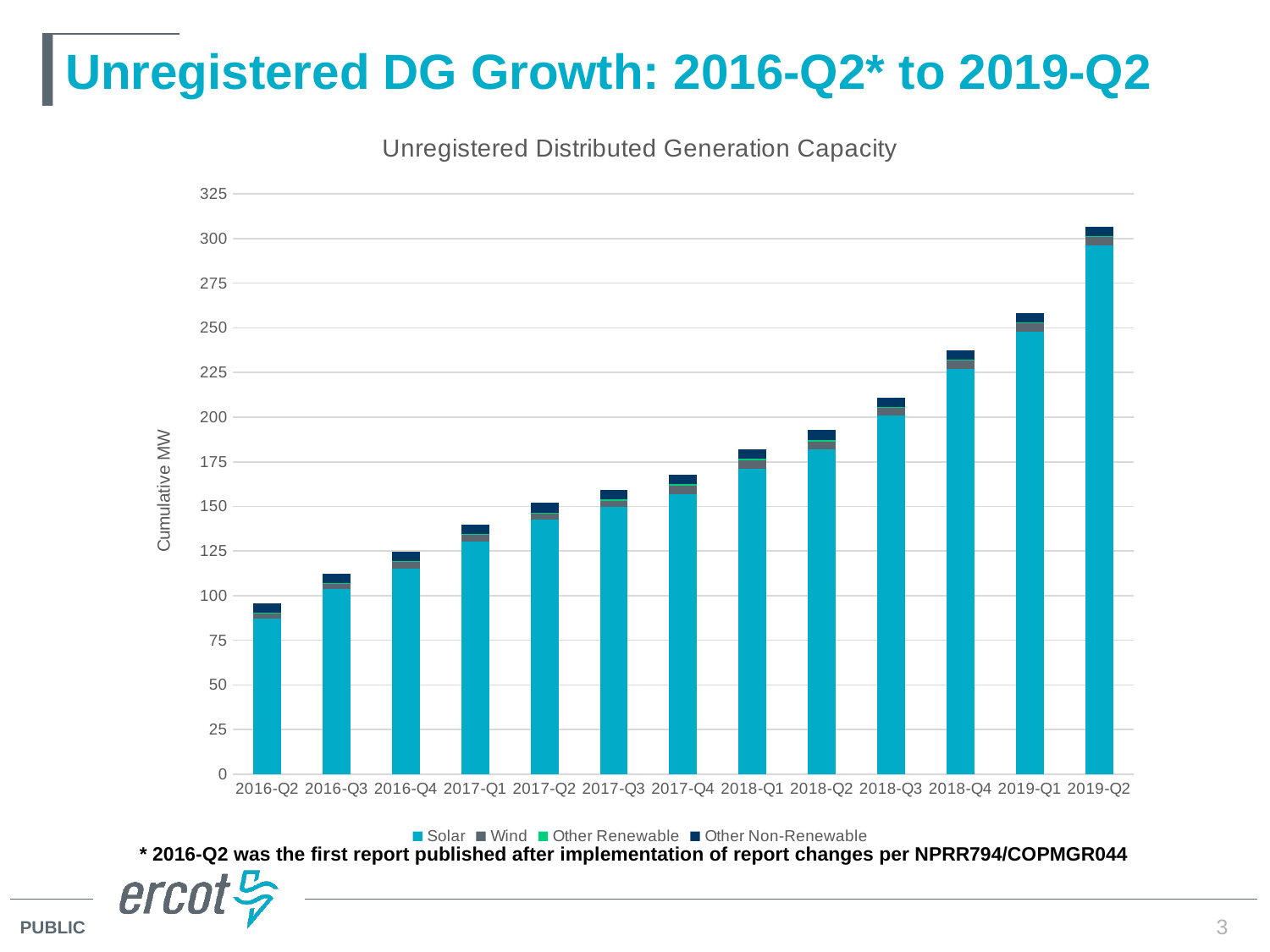
Does the total cumulative capacity rise or fall from 2016-Q2 to 2019-Q2? rise Is the total capacity for 2018-Q3 greater or less than 200 MW? greater Which quarter has the highest total unregistered DG capacity? 2019-Q2 Is the total capacity for 2019-Q2 greater or less than 300 MW? greater What is the label on the chart's vertical axis? Cumulative MW What kind of chart is shown on the slide? Stacked bar chart How many series does the chart's legend list? 4 Is the total capacity for 2017-Q1 greater or less than 150 MW? less Which quarter has a larger total capacity, 2018-Q4 or 2019-Q1? 2019-Q1 Which quarter has the lowest total unregistered DG capacity? 2016-Q2 How many quarters are plotted along the x axis of the chart? 13